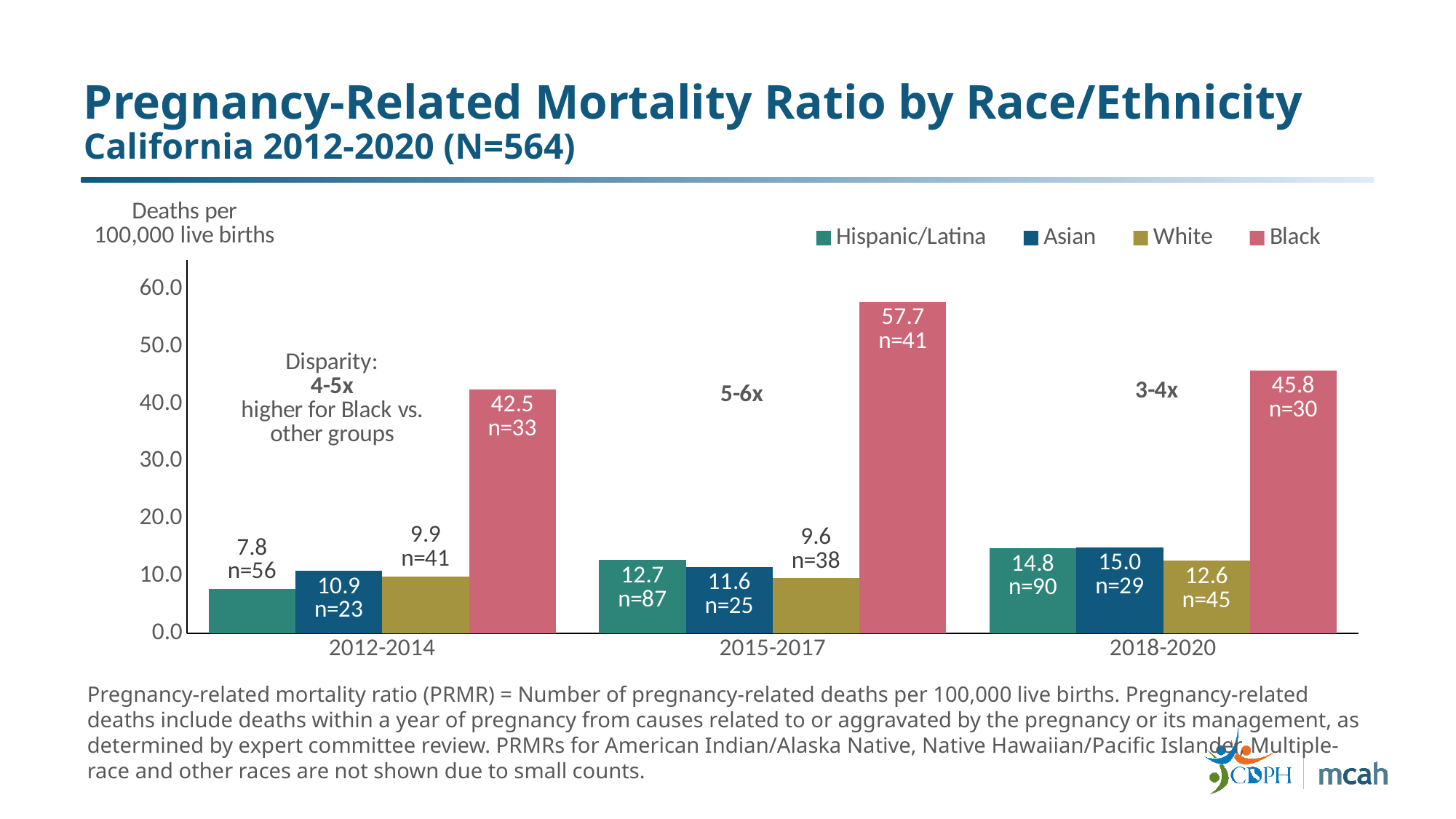
What is the pregnancy-related mortality ratio for Black women in 2015-2017? 57.7 Do the values for Hispanic/Latina women rise or fall across the three time periods? rise Which race/ethnicity group has the lowest mortality ratio in 2012-2014? Hispanic/Latina What is the difference between the Black and White mortality ratios in 2012-2014? 32.6 How many series does the legend list? 4 What is the value for Hispanic/Latina women in 2012-2014? 7.8 Which is larger in 2015-2017: the value for Hispanic/Latina or the value for Asian? Hispanic/Latina What kind of chart is shown on the slide? bar chart Is the value for Black women in 2018-2020 greater or less than 50.0? less Which race/ethnicity group has the highest mortality ratio in 2018-2020? Black What is the value for Asian women in 2018-2020? 15.0 How many time periods are shown on the x axis? 3